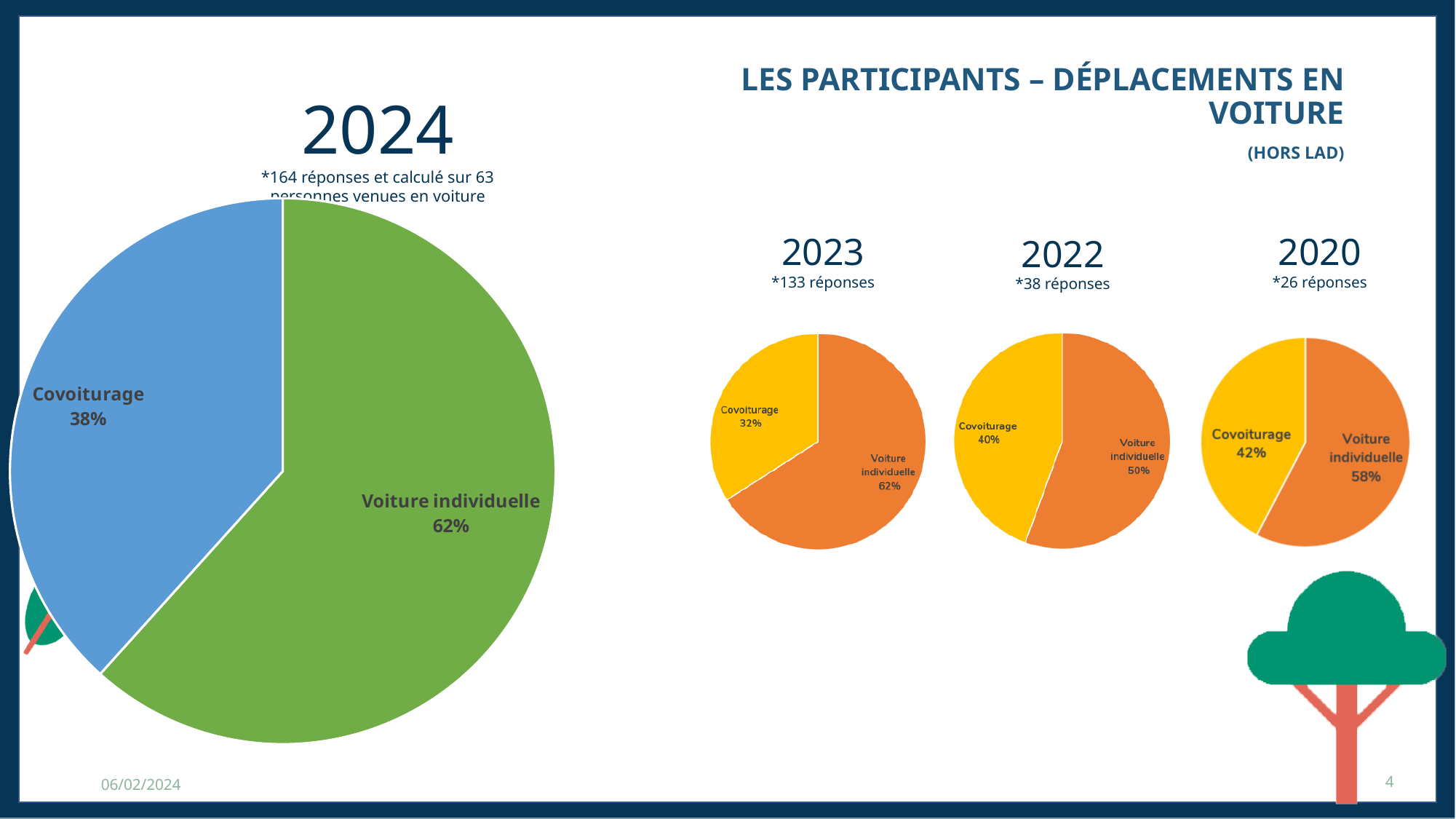
In the 2023 pie chart, what share is labelled for Covoiturage? 32% In the 2024 pie chart, what share is labelled for Voiture individuelle? 62% In the 2023 pie chart, which category has the smallest slice? Covoiturage In the 2020 pie chart, what share is labelled for Voiture individuelle? 58% In the 2020 pie chart, which is larger: Covoiturage or Voiture individuelle? Voiture individuelle In the 2024 pie chart, which category has the largest slice? Voiture individuelle In the 2022 pie chart, what share is labelled for Voiture individuelle? 50% In the 2024 pie chart, what is the difference between the Voiture individuelle share and the Covoiturage share? 24 percentage points How many pie charts are shown on the slide? 4 What type of chart is used for the 2022 data? Pie chart In the 2020 pie chart, what share is labelled for Covoiturage? 42% In the 2024 pie chart, what share is labelled for Covoiturage? 38%